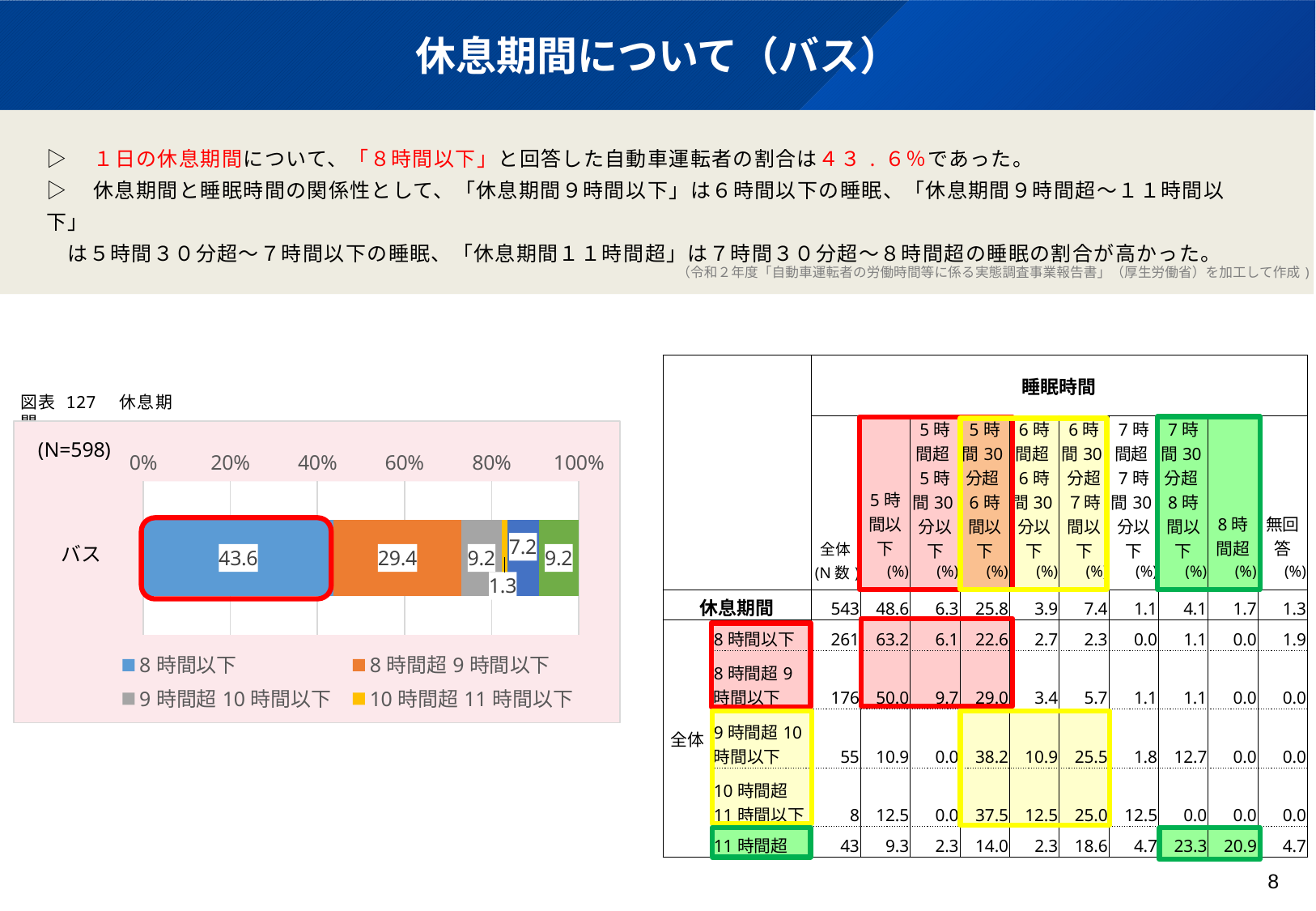
What kind of chart is 図表 127 休息期間? bar chart In the bar chart 図表 127 休息期間, which legend series has the smallest segment? 10時間超11時間以下 In the bar chart 図表 127 休息期間, is the value for 8時間以下 greater or less than 40%? greater In the bar chart 図表 127 休息期間, what is the value for 10時間超11時間以下? 1.3 In the bar chart 図表 127 休息期間, what is the difference between the 8時間以下 value and the 8時間超9時間以下 value? 14.2 In the bar chart 図表 127 休息期間, which is larger: 8時間以下 or 8時間超9時間以下? 8時間以下 In the bar chart 図表 127 休息期間, what is the value for 8時間超9時間以下? 29.4 In the bar chart 図表 127 休息期間, what is the value for 9時間超10時間以下? 9.2 How many series does the legend of the bar chart 図表 127 休息期間 list? 4 What is the N value shown on the bar chart 図表 127 休息期間? N=598 In the bar chart 図表 127 休息期間, which legend series has the largest segment? 8時間以下 In the bar chart 図表 127 休息期間, what is the value for 8時間以下? 43.6